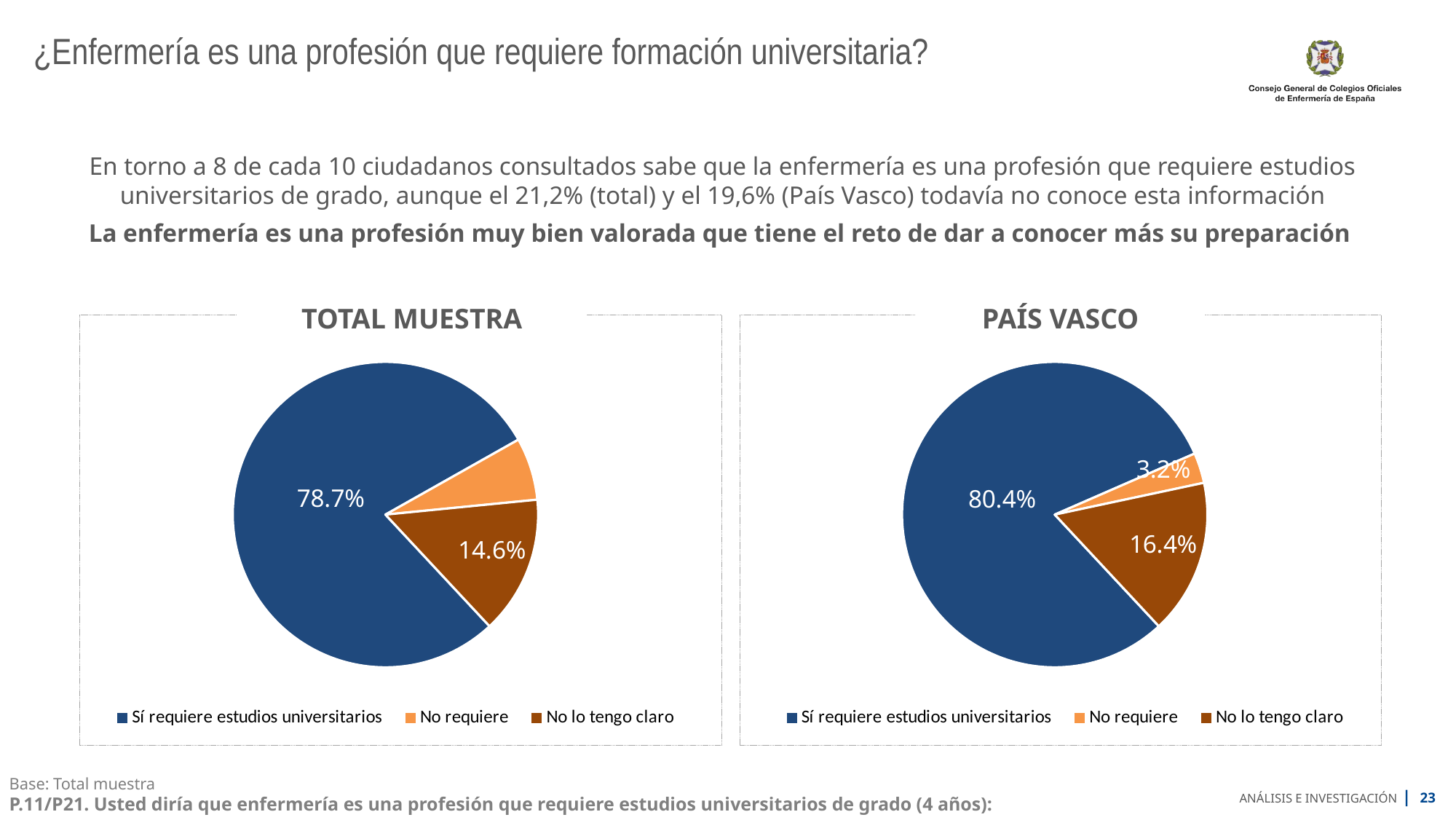
In the TOTAL MUESTRA chart, what percentage answered 'Sí requiere estudios universitarios'? 78.7% In the PAÍS VASCO chart, which category has the largest share? Sí requiere estudios universitarios In the PAÍS VASCO chart, what percentage answered 'No requiere'? 3.2% What type of chart is the TOTAL MUESTRA chart? Pie chart In the PAÍS VASCO chart, what is the difference between 'No lo tengo claro' and 'No requiere'? 13.2% Which is larger: 'No lo tengo claro' in the TOTAL MUESTRA chart or 'No lo tengo claro' in the PAÍS VASCO chart? PAÍS VASCO In the PAÍS VASCO chart, which category has the smallest share? No requiere In the PAÍS VASCO chart, what percentage answered 'No lo tengo claro'? 16.4% What is the difference between the 'Sí requiere estudios universitarios' share in the PAÍS VASCO chart and in the TOTAL MUESTRA chart? 1.7% In the TOTAL MUESTRA chart, which category has the smallest share? No requiere In the TOTAL MUESTRA chart, what percentage answered 'No lo tengo claro'? 14.6% In the PAÍS VASCO chart, what percentage answered 'Sí requiere estudios universitarios'? 80.4%